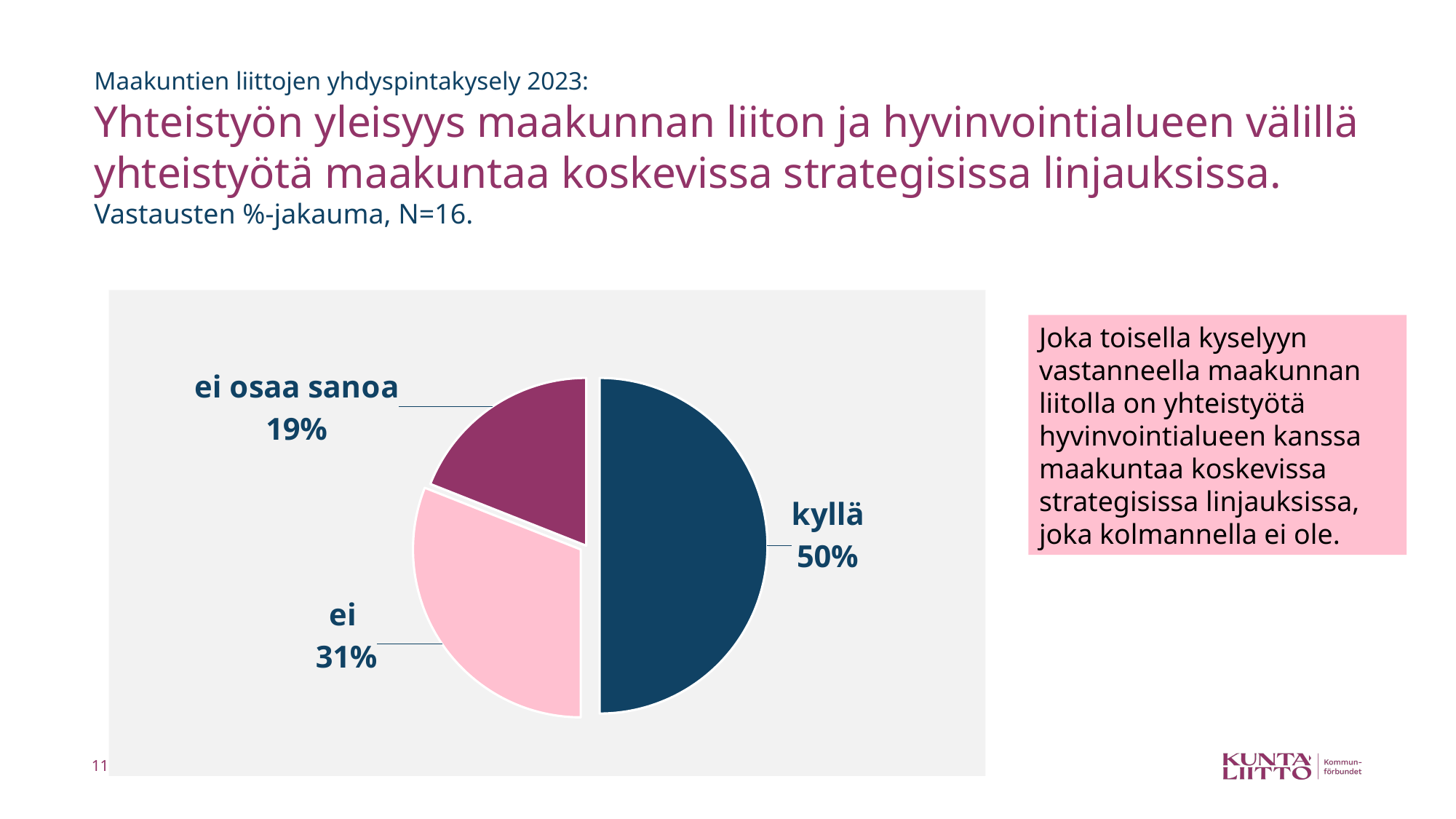
Which response category has the smallest share of the pie? ei osaa sanoa Which is larger, the share for 'ei' or the share for 'ei osaa sanoa'? ei What percentage of responses is 'ei'? 31% What is the difference in percentage points between 'kyllä' and 'ei'? 19 What percentage of responses is 'kyllä'? 50% What kind of chart is shown on the slide? pie chart How many slices does the pie chart have? 3 How many respondents (N) does the chart subtitle state? 16 What colour is the 'kyllä' slice? dark blue Which response category has the largest share of the pie? kyllä What percentage of responses is 'ei osaa sanoa'? 19% What is the difference in percentage points between 'ei' and 'ei osaa sanoa'? 12